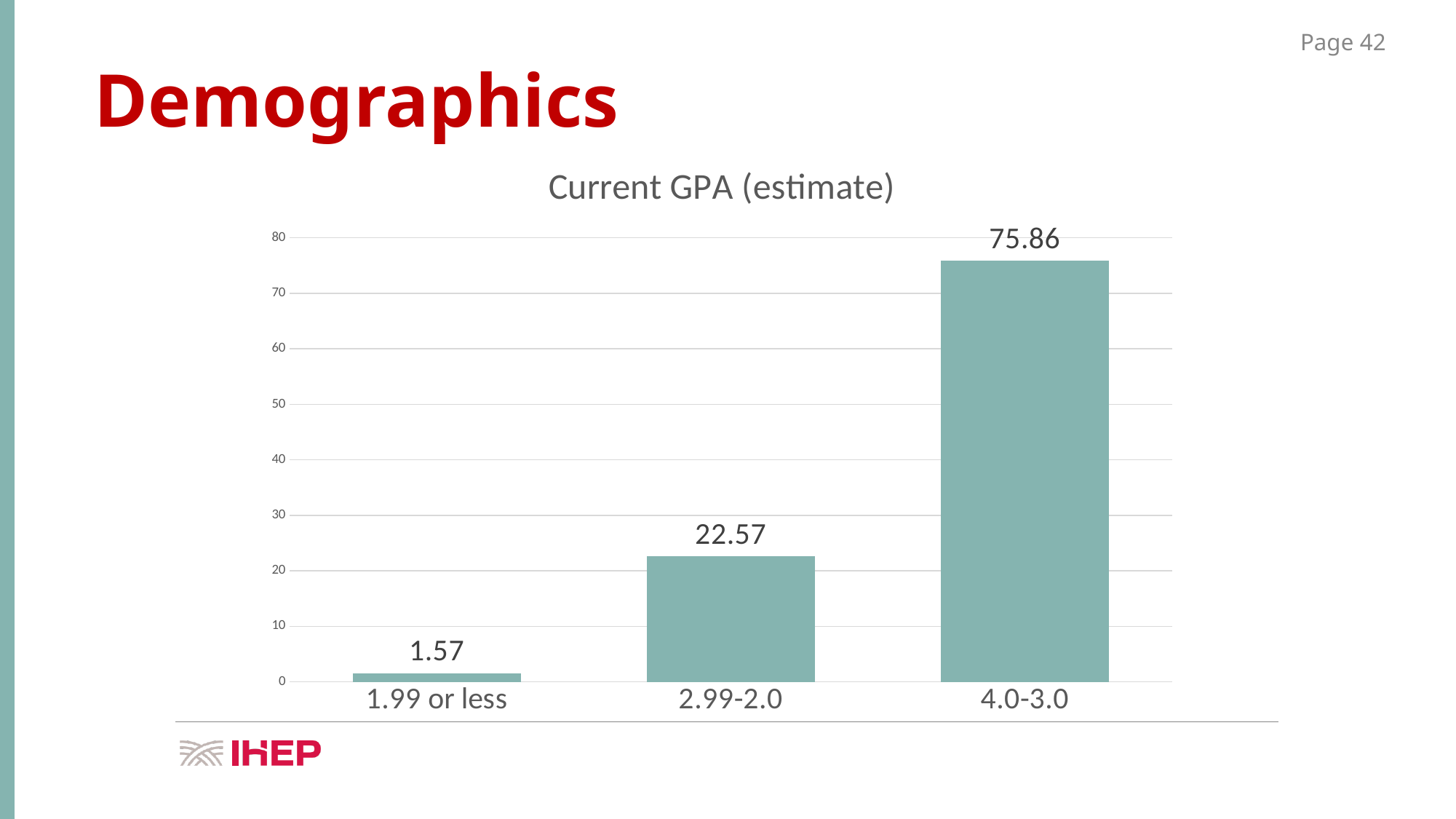
What kind of chart is shown on the slide? bar chart What is the title of the chart? Current GPA (estimate) Which is larger, the value for 2.99-2.0 or the value for 1.99 or less? 2.99-2.0 What is the value for the 4.0-3.0 category? 75.86 What is the difference between the values for 2.99-2.0 and 1.99 or less? 21.00 Is the value for 4.0-3.0 greater or less than 70? greater What is the difference between the values for 4.0-3.0 and 2.99-2.0? 53.29 Which GPA category has the highest value? 4.0-3.0 What is the value for the 2.99-2.0 category? 22.57 Which GPA category has the lowest value? 1.99 or less What is the value for the 1.99 or less category? 1.57 How many GPA categories are shown in the chart? 3